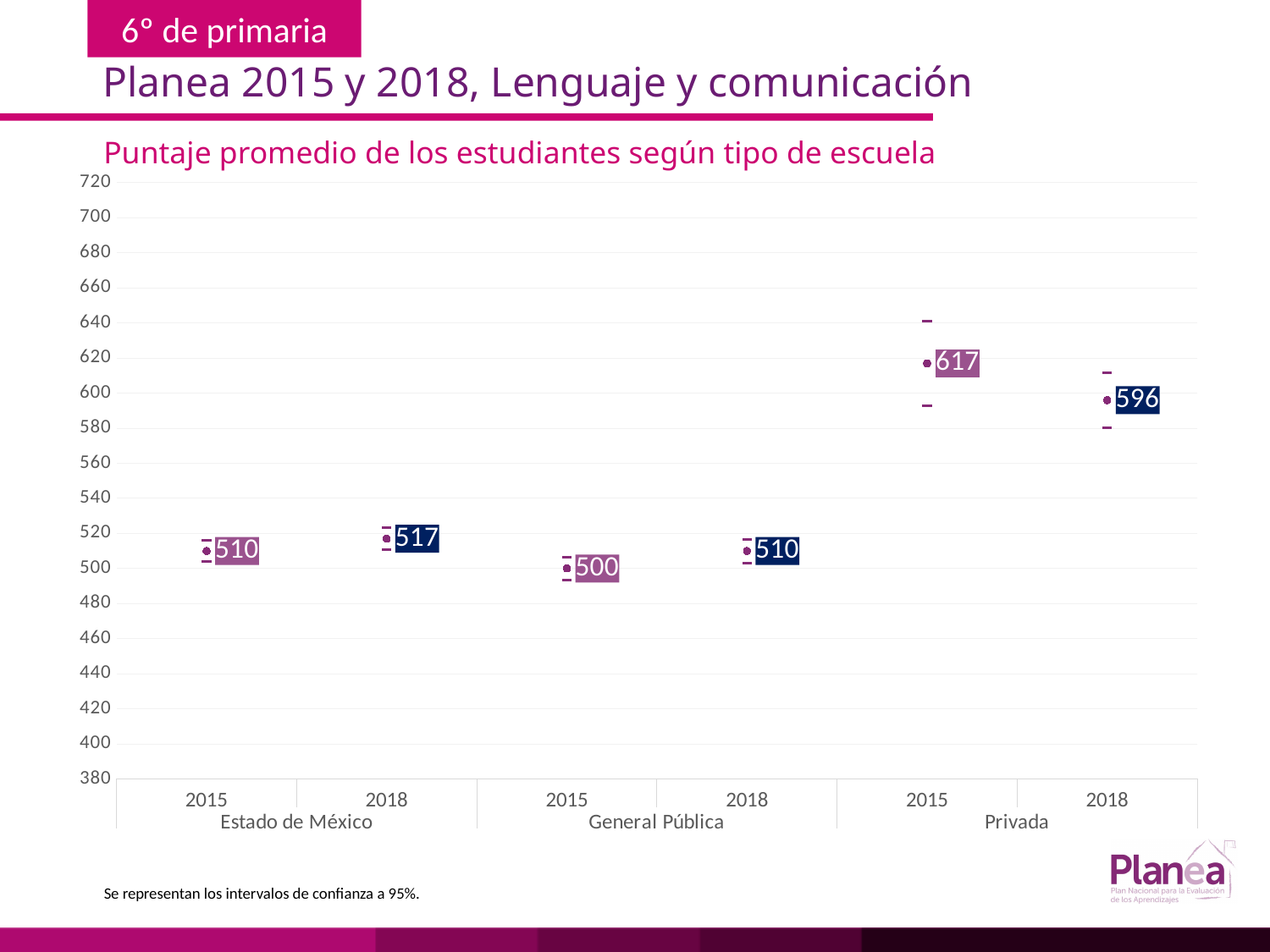
What is the average score for Estado de México in 2015? 510 What is the average score for Privada in 2015? 617 What is the average score for General Pública in 2015? 500 Which is larger, the Estado de México score in 2018 or the General Pública score in 2018? Estado de México 2018 What is the average score for Privada in 2018? 596 What is the difference between the General Pública scores in 2018 and 2015? 10 Which school type and year has the lowest average score? General Pública 2015 What is the difference between the Privada scores in 2015 and 2018? 21 Did the Privada average score rise or fall from 2015 to 2018? fall What is the average score for Estado de México in 2018? 517 Which school type and year has the highest average score? Privada 2015